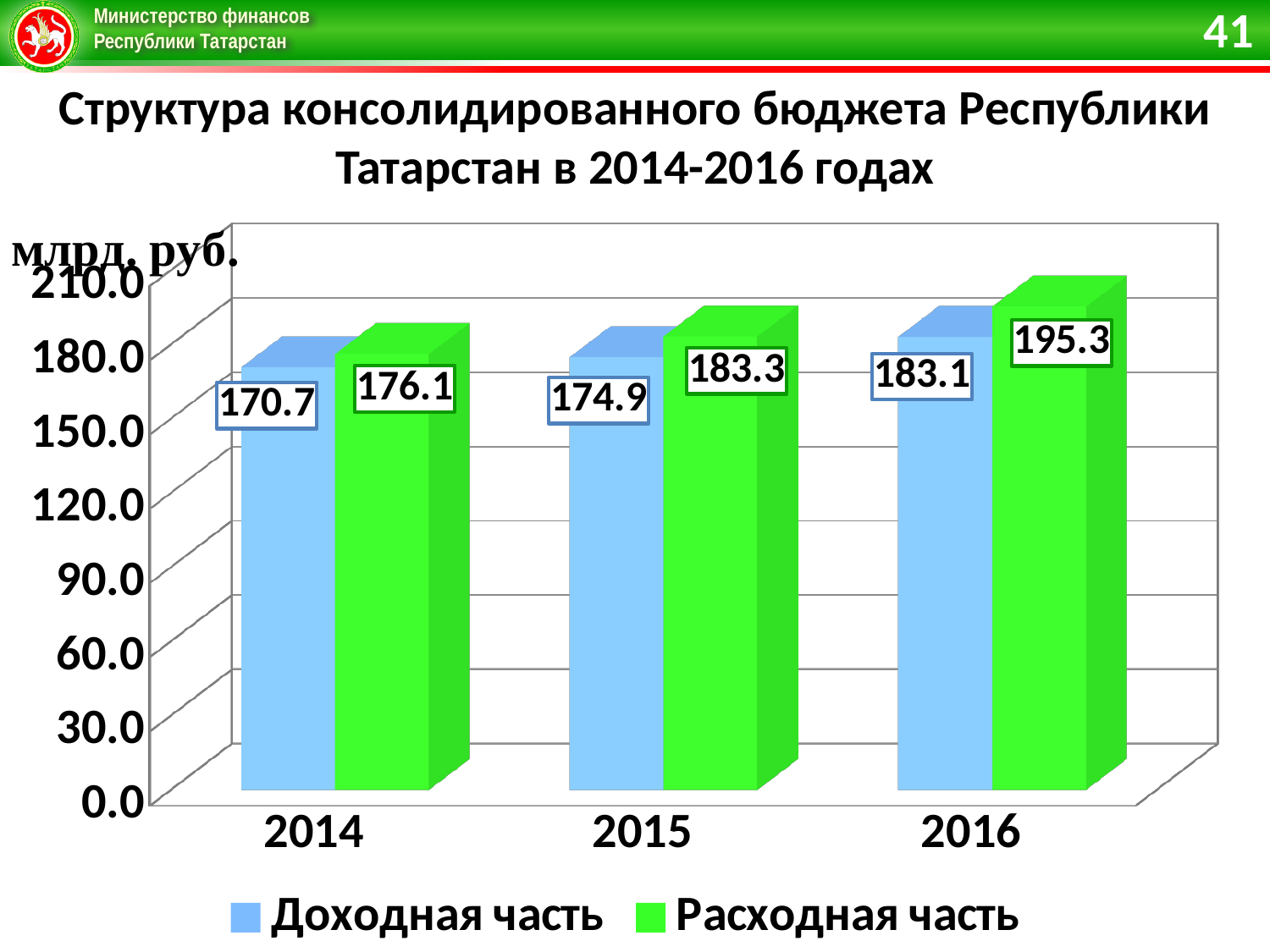
Which year has the lowest value for Доходная часть? 2014 What is the value of Расходная часть for 2015? 183.3 What is the value of Доходная часть for 2014? 170.7 How many years are shown on the x axis? 3 Which year has the highest value for Расходная часть? 2016 How many series does the legend list? 2 What is the difference between Доходная часть in 2015 and in 2014? 4.2 What is the difference between Расходная часть and Доходная часть in 2016? 12.2 Does Доходная часть rise or fall from 2014 to 2016? Rise What kind of chart is shown on the slide? Bar chart What is the value of Расходная часть for 2016? 195.3 Which is larger in 2015: Доходная часть or Расходная часть? Расходная часть